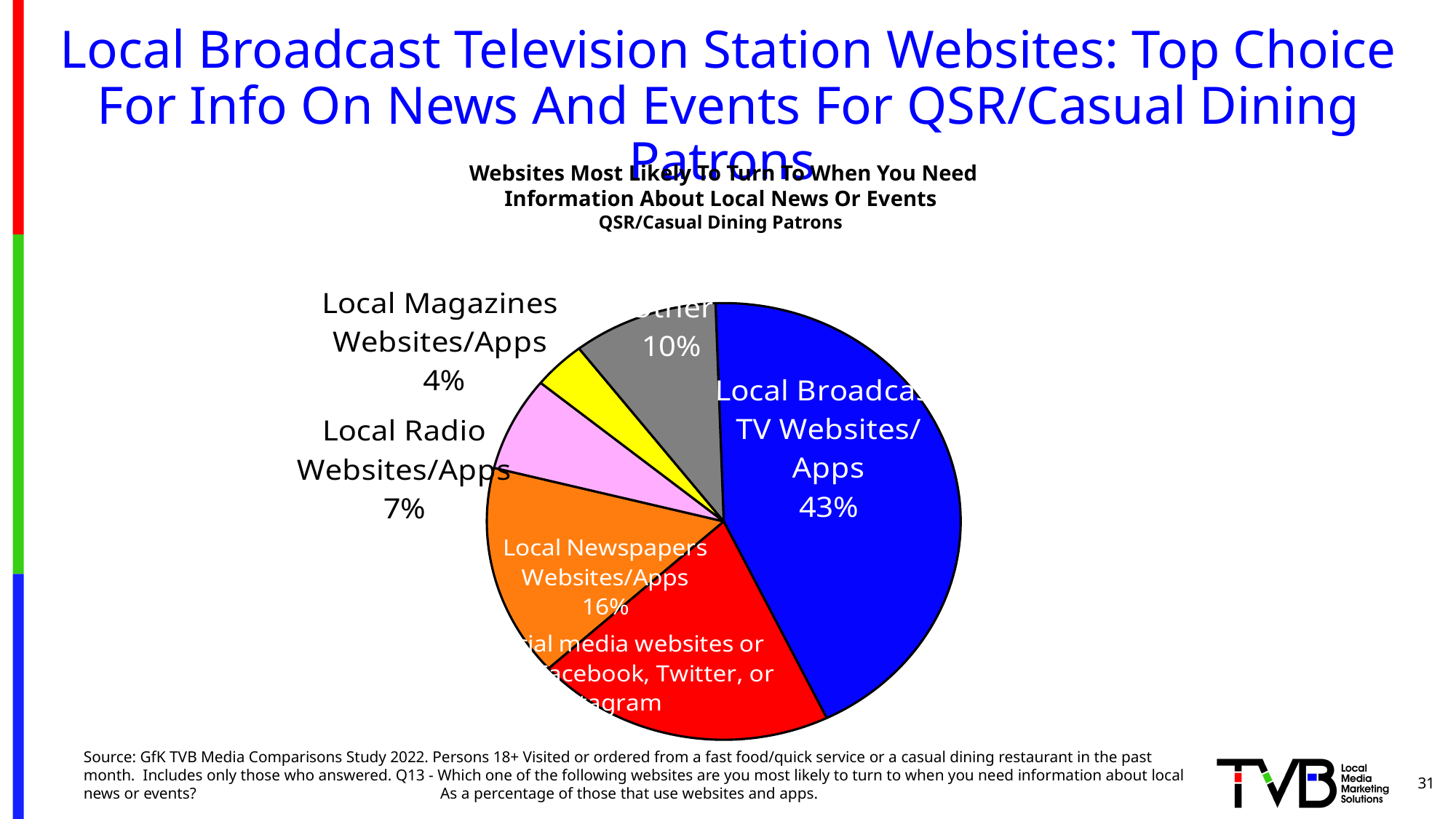
What share of the pie is Local Newspapers Websites/Apps? 16% Which labeled website category has the smallest share of the pie? Local Magazines Websites/Apps What percentage of QSR/Casual Dining Patrons are most likely to turn to Local Broadcast TV Websites/Apps for local news or events? 43% Which website category has the largest share of the pie? Local Broadcast TV Websites/Apps What percentage is shown for Local Magazines Websites/Apps? 4% What kind of chart is shown on the slide? pie chart What colour is the Local Broadcast TV Websites/Apps slice? blue What percentage is shown for the Other slice? 10% Which is larger: the share for Local Radio Websites/Apps or Local Magazines Websites/Apps? Local Radio Websites/Apps How many slices does the pie chart have? 6 What percentage is shown for Local Radio Websites/Apps? 7% How many percentage points larger is Local Broadcast TV Websites/Apps than Local Newspapers Websites/Apps? 27